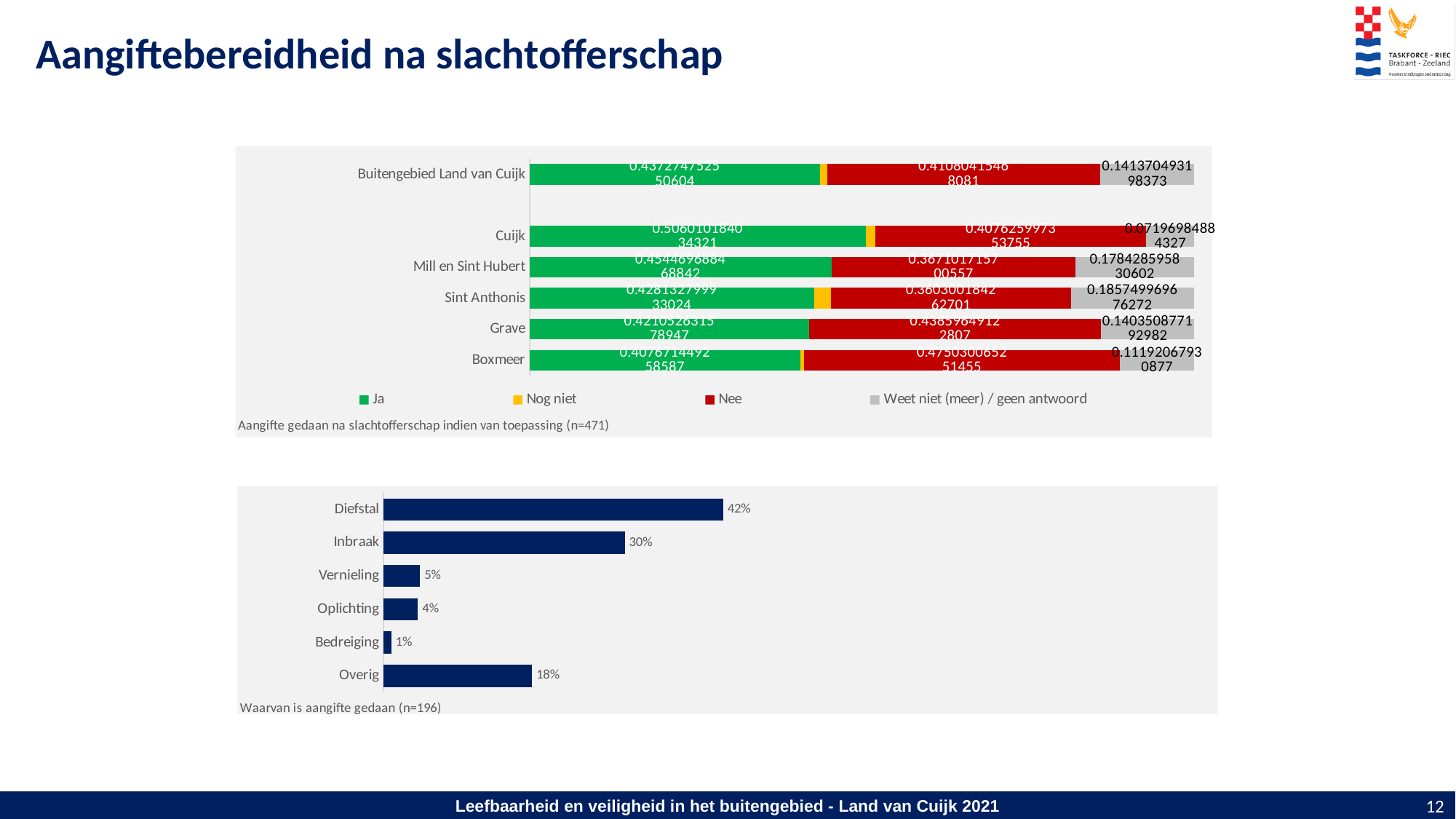
In the bottom chart (Waarvan is aangifte gedaan), what is the value for Diefstal? 42% How many series does the legend of the top chart (Aangifte gedaan na slachtofferschap) list? 4 In the bottom chart (Waarvan is aangifte gedaan), which category has the highest value? Diefstal What kind of chart is the top chart (Aangifte gedaan na slachtofferschap)? Stacked bar chart In the bottom chart (Waarvan is aangifte gedaan), which category has the lowest value? Bedreiging In the bottom chart (Waarvan is aangifte gedaan), what is the value for Overig? 18% How many categories are shown in the bottom chart (Waarvan is aangifte gedaan)? 6 In the top chart (Aangifte gedaan na slachtofferschap), which is larger for Boxmeer, the Ja segment or the Nee segment? Nee In the bottom chart (Waarvan is aangifte gedaan), what is the difference between Diefstal and Inbraak? 12% In the bottom chart (Waarvan is aangifte gedaan), what is the value for Inbraak? 30% In the bottom chart (Waarvan is aangifte gedaan), which is larger, Vernieling or Oplichting? Vernieling In the top chart (Aangifte gedaan na slachtofferschap), which legend entry is shown in yellow? Nog niet